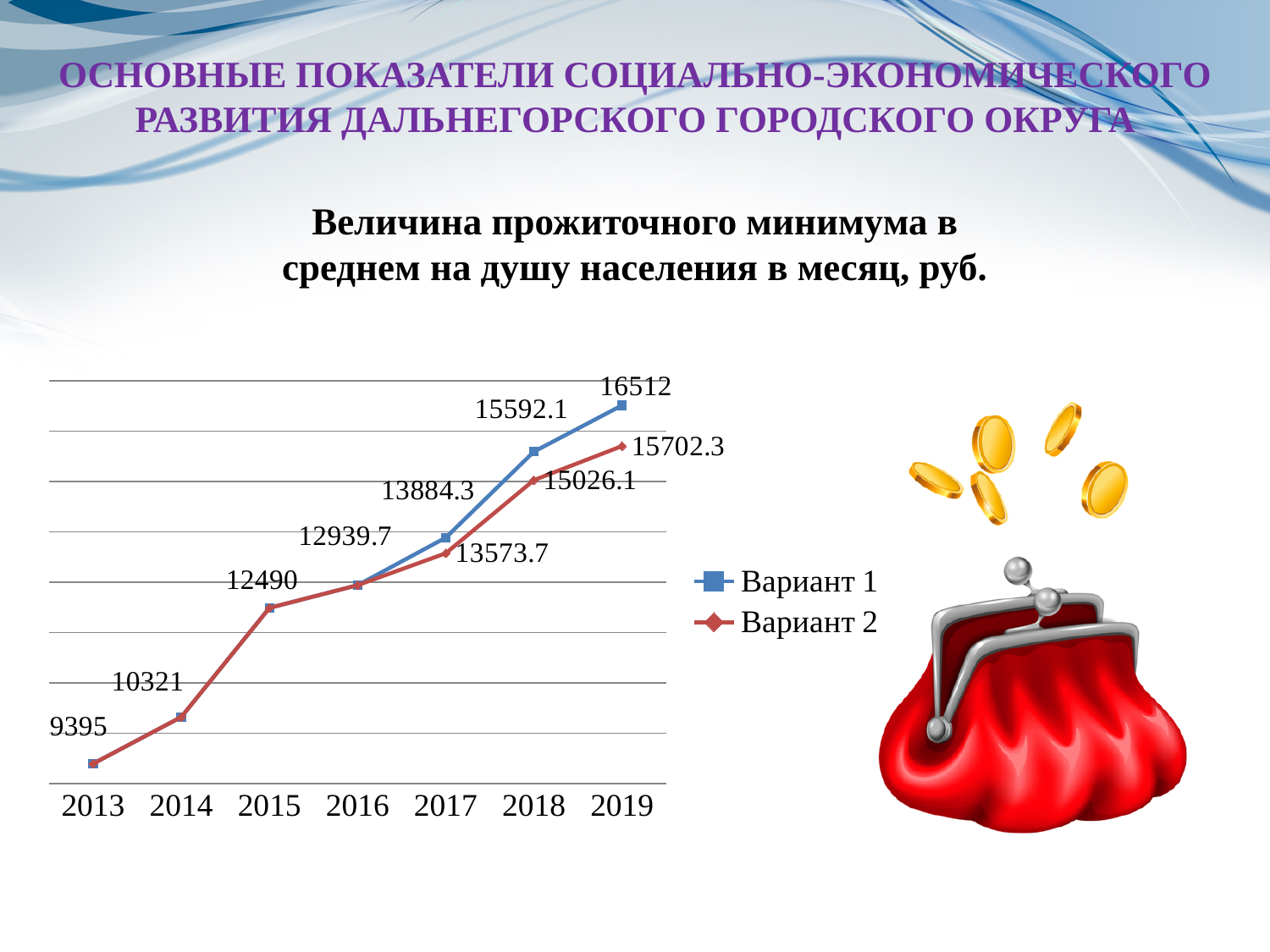
Do the values rise or fall from 2013 to 2019? rise What type of chart is shown on the slide? line chart Which year has the lowest value on the chart? 2013 What is the difference between Вариант 1 and Вариант 2 in 2019? 809.7 In 2018, which series has the larger value, Вариант 1 or Вариант 2? Вариант 1 How many series does the legend list? 2 What is the value for Вариант 1 in 2017? 13884.3 What is the value for Вариант 2 in 2018? 15026.1 What is the value for Вариант 2 in 2019? 15702.3 What is the value shown for 2013? 9395 How many years are shown on the x axis of the chart? 7 What is the value for Вариант 1 in 2019? 16512